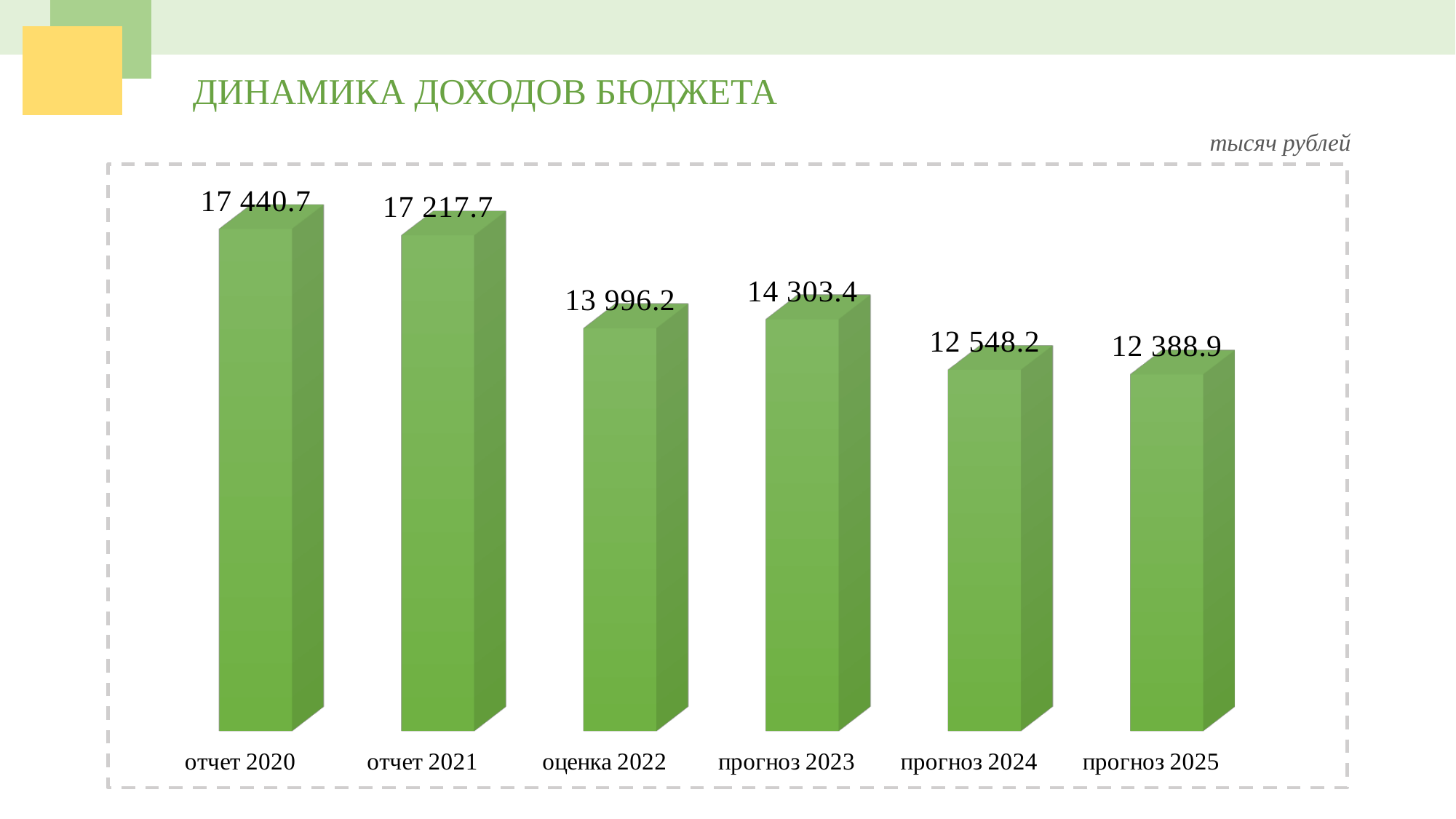
Which category has the highest value? отчет 2020 What is the value for отчет 2020? 17 440.7 How many categories are shown on the chart? 6 What is the value for прогноз 2025? 12 388.9 What is the difference between the values for прогноз 2023 and оценка 2022? 307.2 What kind of chart is shown on the slide? bar chart What is the difference between the values for отчет 2020 and отчет 2021? 223.0 Which is larger, the value for оценка 2022 or the value for прогноз 2023? прогноз 2023 Do the values generally rise or fall from отчет 2020 to прогноз 2025? fall What is the title of the chart? ДИНАМИКА ДОХОДОВ БЮДЖЕТА Which category has the lowest value? прогноз 2025 What is the value for прогноз 2023? 14 303.4